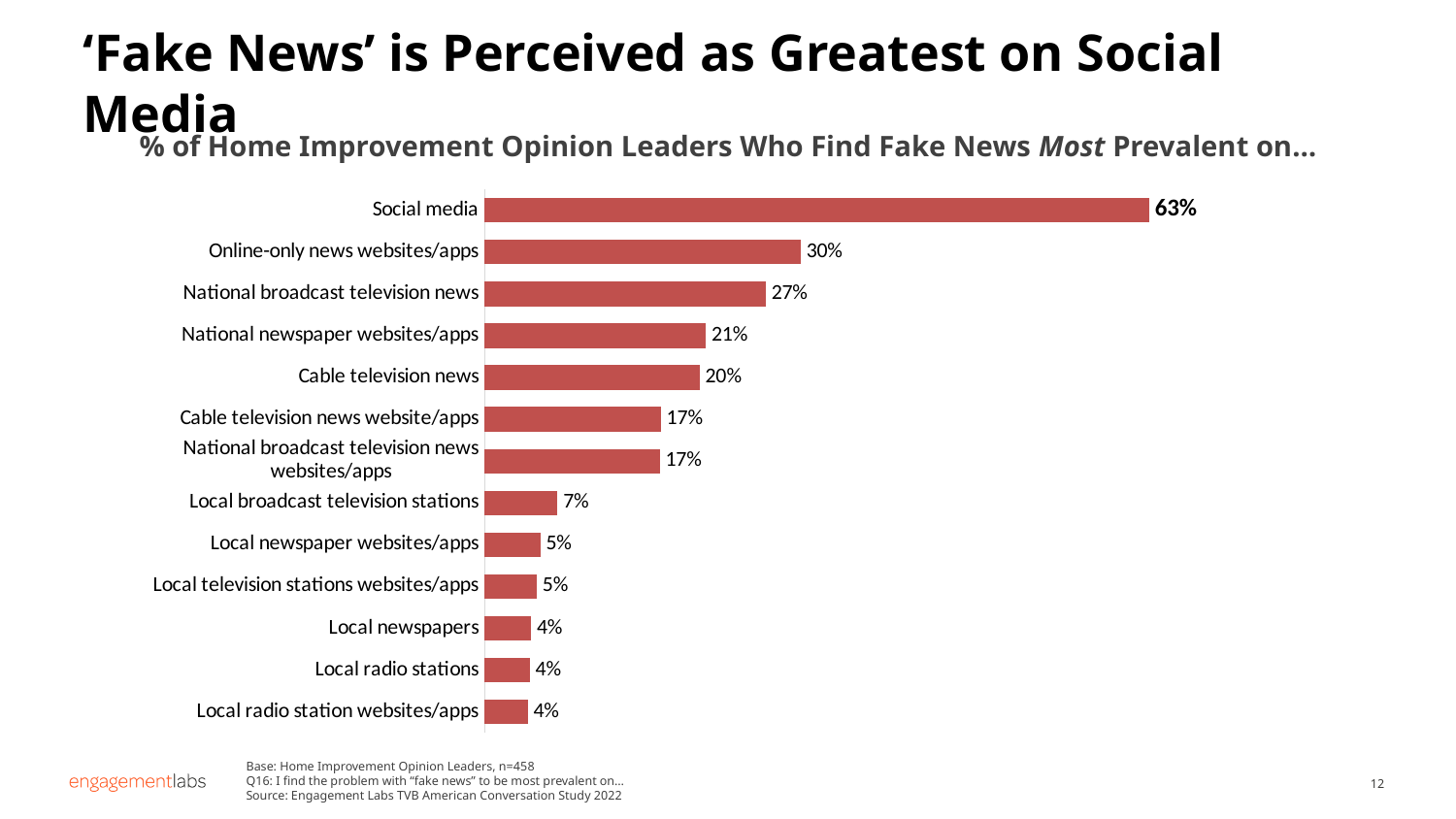
What is the value for Local broadcast television stations? 7% What is the value for Online-only news websites/apps? 30% What is the difference between National broadcast television news and National newspaper websites/apps? 6% Which is larger, the value for Cable television news or the value for Local newspapers? Cable television news How many categories are shown in the chart? 13 Which category has the highest value? Social media What percentage of Home Improvement Opinion Leaders find fake news most prevalent on social media? 63% What is the value for Cable television news? 20% What is the base sample size noted below the chart? n=458 What kind of chart is shown on the slide? Bar chart What is the value for Local radio station websites/apps? 4% What is the difference between the values for Social media and Online-only news websites/apps? 33%